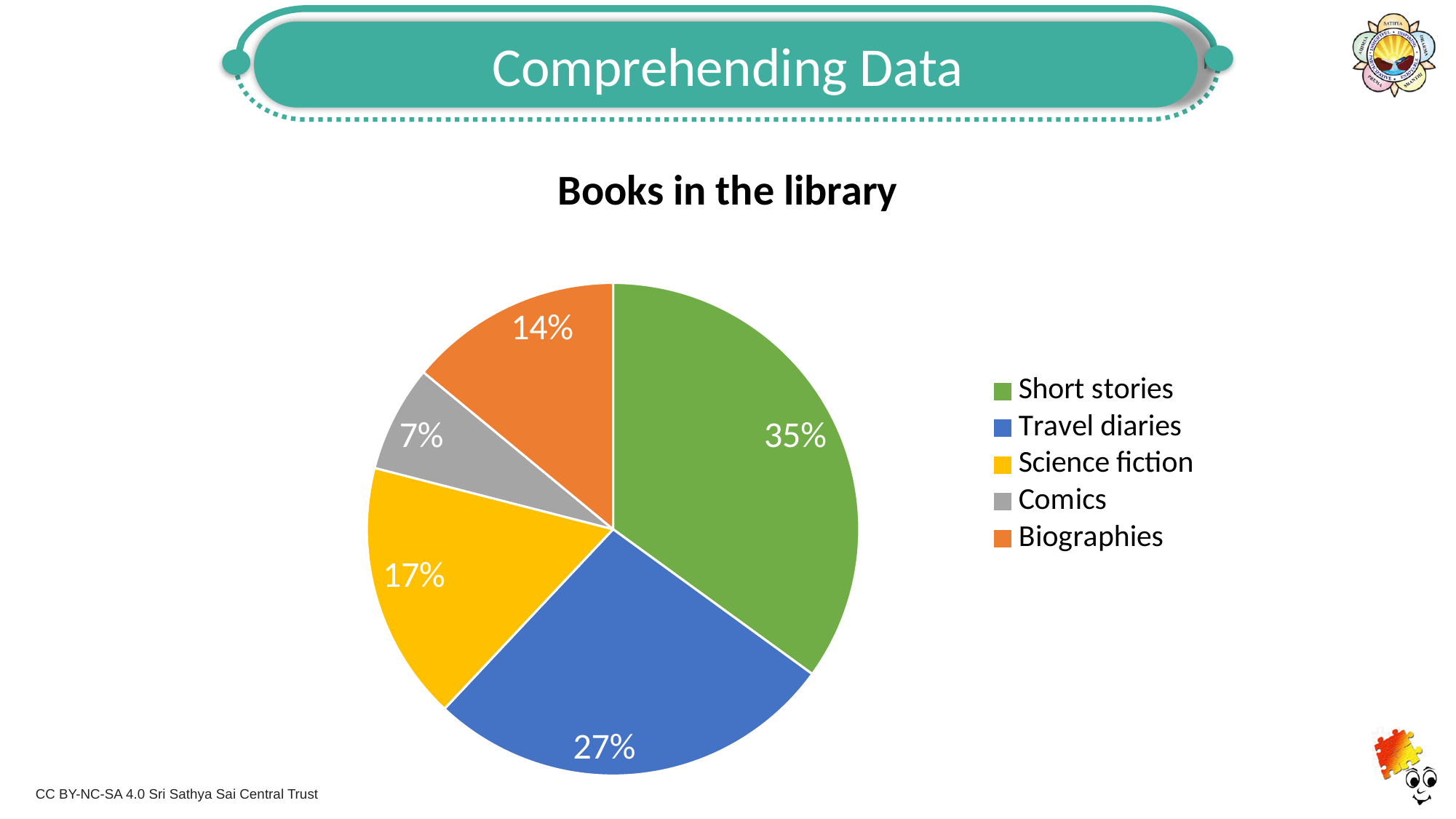
What is the value for Travel diaries? 27% What kind of chart is shown on the slide? Pie chart What is the title of the chart? Books in the library What is the value for Science fiction? 17% Which is larger, Science fiction or Biographies? Science fiction What is the value for Comics? 7% What is the difference between the Short stories and Travel diaries shares? 8% How many categories are shown in the pie chart? 5 Which category has the largest slice? Short stories What share of the pie does Short stories have? 35% What is the value for Biographies? 14% Which category has the smallest slice? Comics